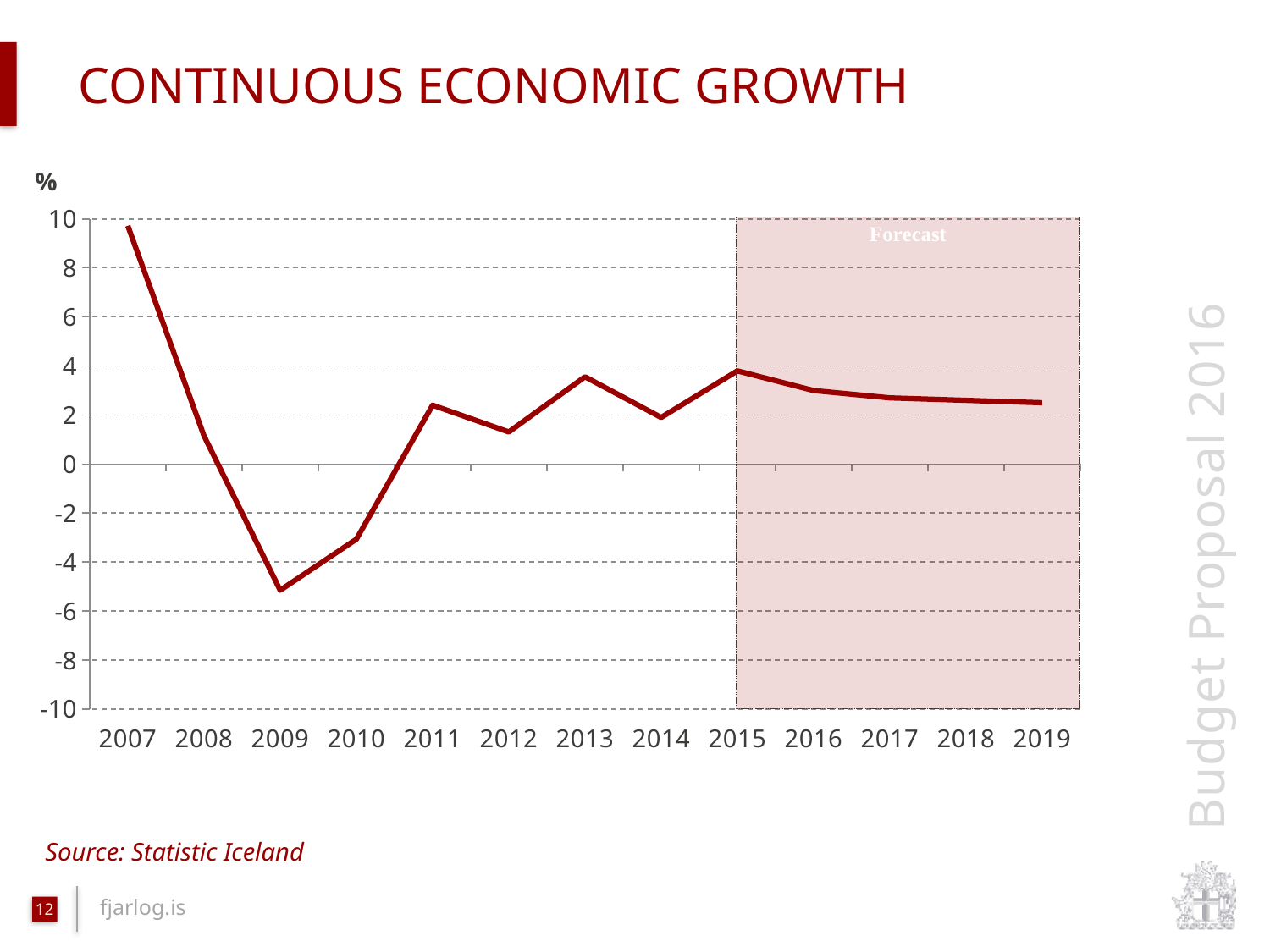
Which year has the highest economic growth value? 2007 Is the value for 2013 greater or less than 2? greater How many years are plotted along the x axis? 13 Do the values rise or fall from 2015 to 2019? fall What is the title of the slide containing the chart? CONTINUOUS ECONOMIC GROWTH What kind of chart is shown on the slide? line chart Which year has the lowest economic growth value? 2009 Which year has the larger value, 2011 or 2012? 2011 Is the value for 2009 greater or less than -4? less What label is shown in the shaded area covering 2015 to 2019? Forecast Is the value for 2010 greater or less than -2? less